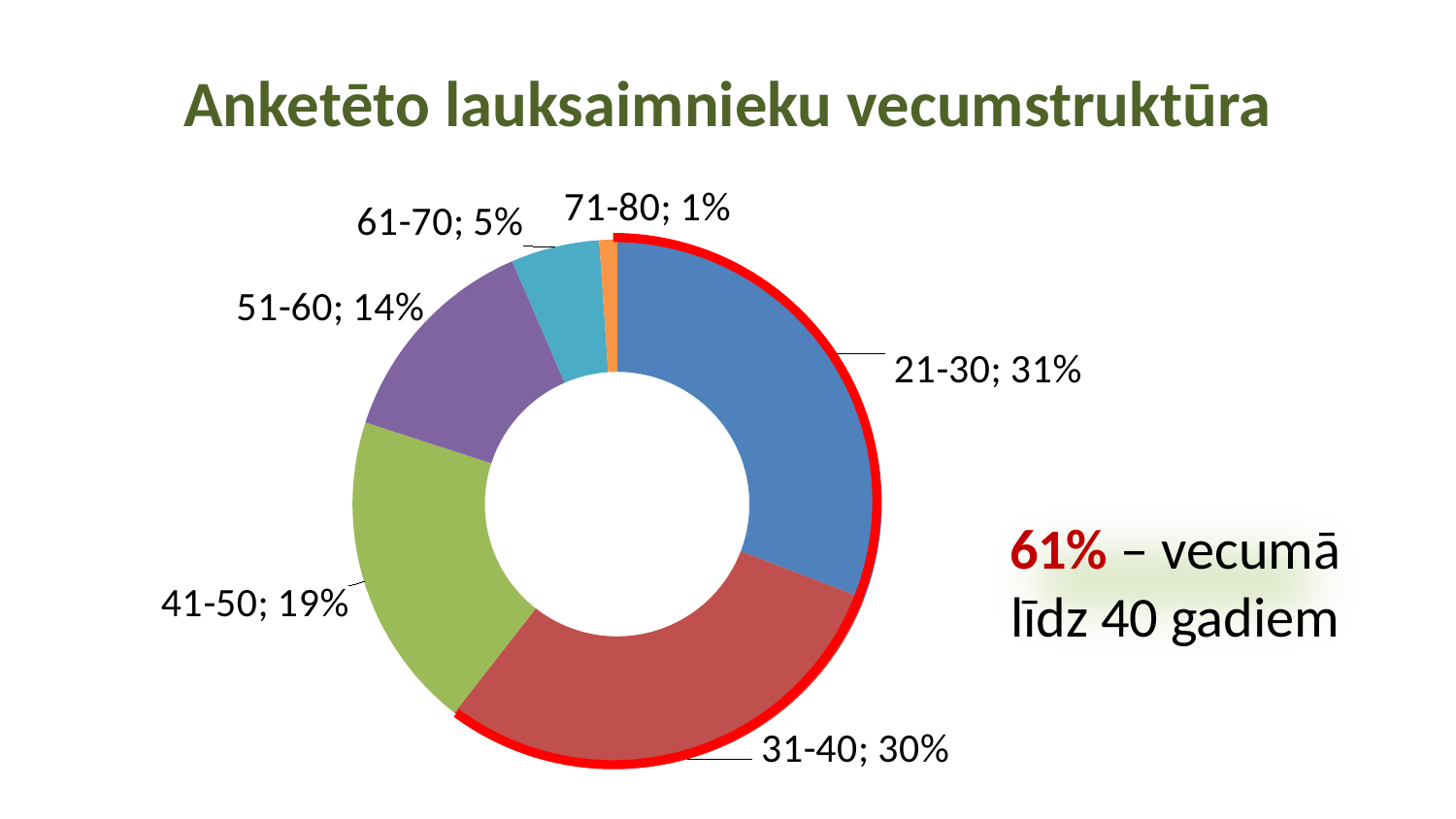
What share of the surveyed farmers are aged 51-60? 14% How many age groups are shown in the chart? 6 Which age group has the largest share of the pie? 21-30 What share of the surveyed farmers are aged 61-70? 5% What kind of chart is shown on the slide? Pie chart (doughnut) What share of the surveyed farmers are aged 21-30? 31% Which age group has the smallest share of the pie? 71-80 What is the difference in percentage points between the 41-50 and 51-60 age groups? 5 Which age group has a larger share, 31-40 or 41-50? 31-40 What is the title of the chart? Anketēto lauksaimnieku vecumstruktūra What is the combined share of the 21-30 and 31-40 age groups? 61% What colour is the slice for the 41-50 age group? Green